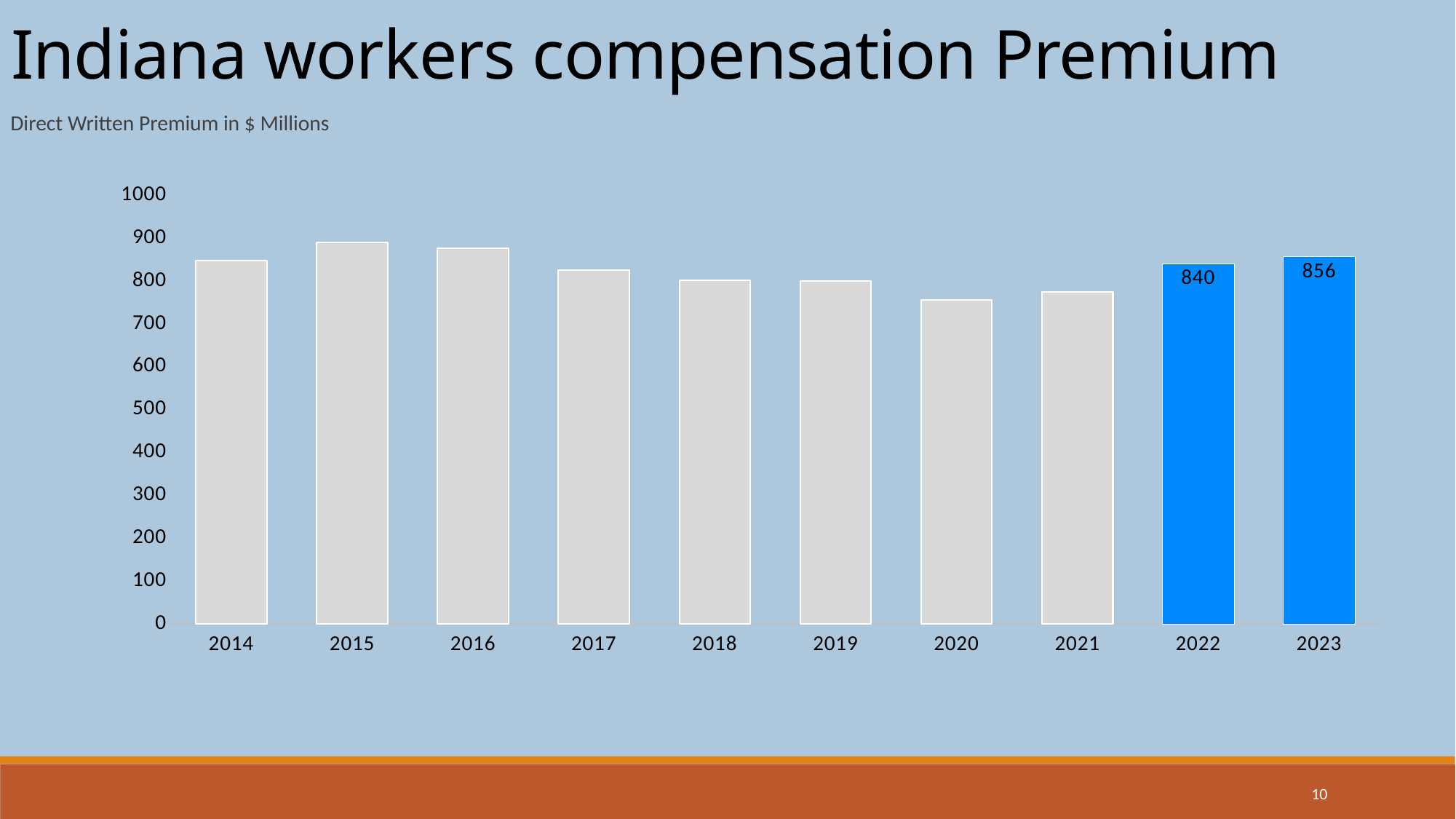
Which year has a larger value, 2022 or 2023? 2023 Is the value for 2021 greater or less than 800? less What is the value for 2022? 840 What is the value for 2023? 856 How many years are shown on the x axis? 10 What kind of chart is shown on the slide? bar chart Which year has a larger value, 2015 or 2020? 2015 Is the value for 2020 greater or less than 800? less In what units is the premium shown, according to the subtitle? $ Millions Is the value for 2015 greater or less than 800? greater What is the difference between the values for 2023 and 2022? 16 Which year has the highest bar? 2015